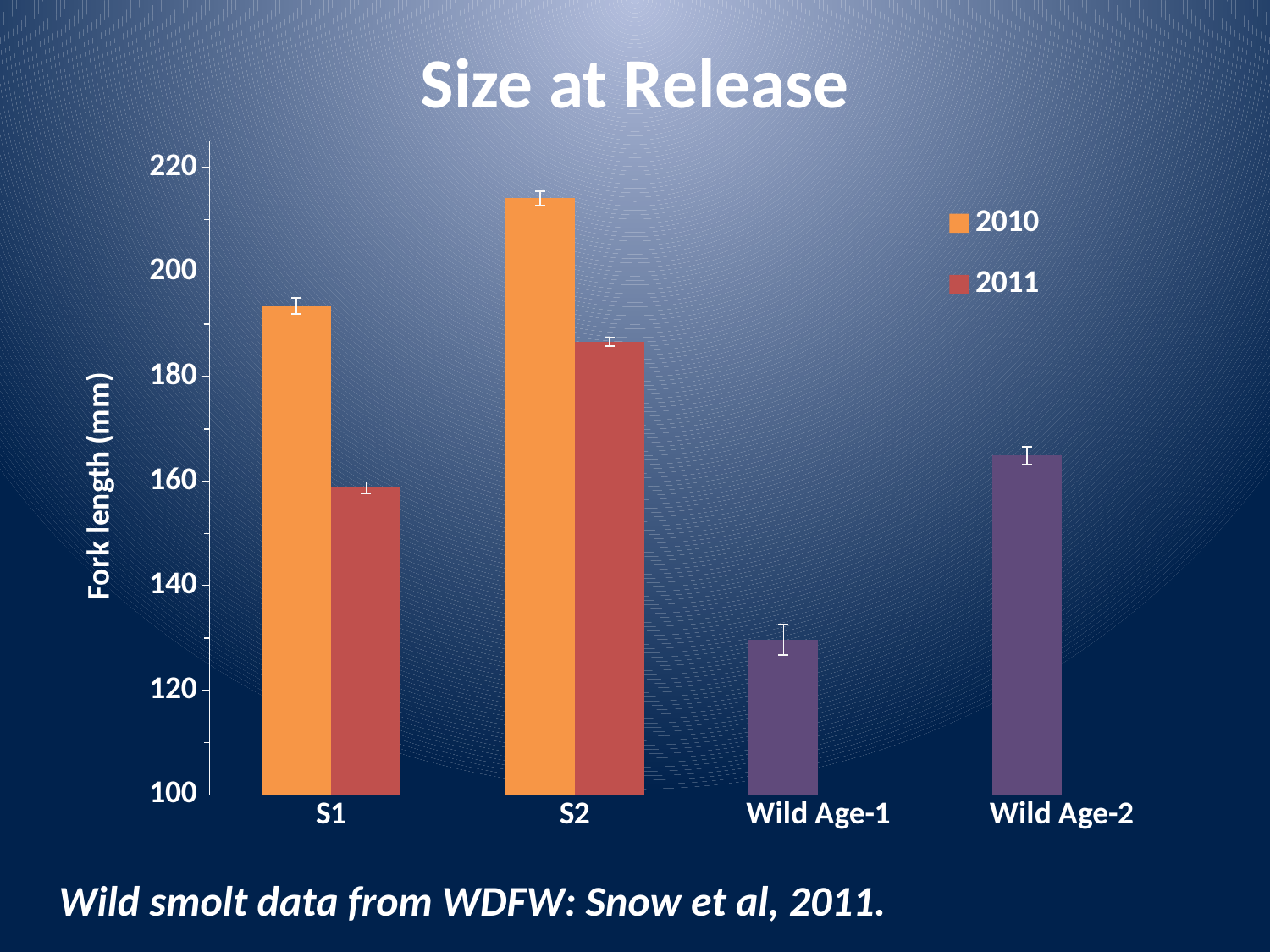
Which category has the lowest fork length? Wild Age-1 What is the label on the vertical axis? Fork length (mm) Which bar is the tallest in the chart? S2, 2010 How many categories are shown along the x axis? 4 Is the 2010 value for S2 greater or less than 200? greater Which is larger, the value for Wild Age-1 or Wild Age-2? Wild Age-2 For S1, which year has the larger fork length, 2010 or 2011? 2010 What kind of chart is shown on the slide? bar chart Is the value for Wild Age-1 greater or less than 140? less Is the 2011 value for S1 greater or less than 140? greater How many series does the legend list? 2 What is the title of the chart? Size at Release